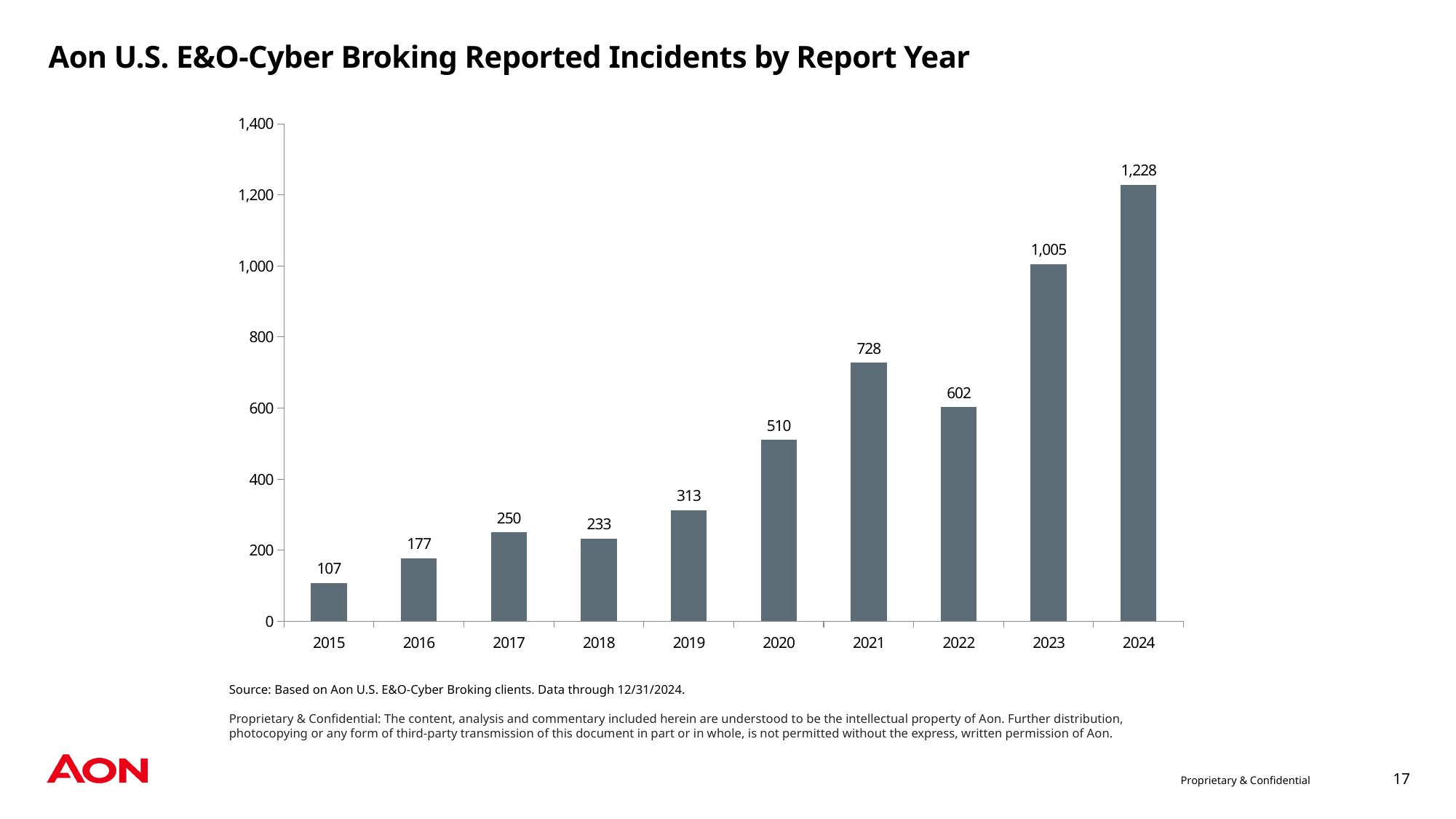
Is the value for 2021 greater or less than 600? greater What is the difference in reported incidents between 2024 and 2023? 223 What is the number of reported incidents for report year 2020? 510 What kind of chart is shown on the slide? Bar chart What is the number of reported incidents for report year 2024? 1,228 Which report year has the highest number of reported incidents? 2024 What is the difference in reported incidents between 2021 and 2022? 126 Which report year has more reported incidents, 2017 or 2018? 2017 What is the title of the chart? Aon U.S. E&O-Cyber Broking Reported Incidents by Report Year What is the number of reported incidents for report year 2018? 233 Which report year has the lowest number of reported incidents? 2015 How many report years are shown on the chart? 10